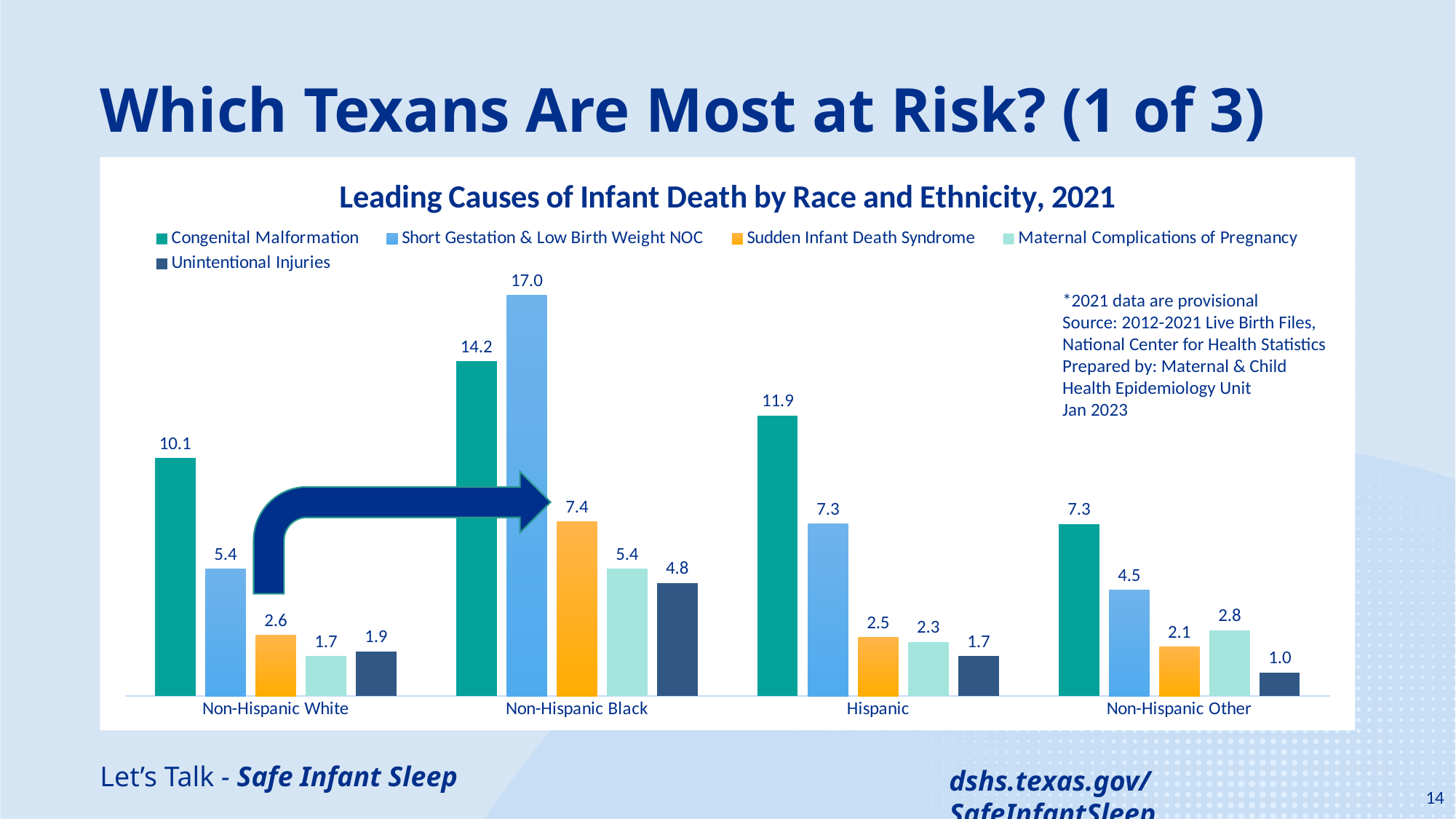
Which race/ethnicity group has the highest value for Short Gestation & Low Birth Weight NOC? Non-Hispanic Black What is the title of the chart? Leading Causes of Infant Death by Race and Ethnicity, 2021 What is the difference between the Congenital Malformation values for Non-Hispanic Black and Non-Hispanic White? 4.1 How many series does the legend list? 5 What is the value for Sudden Infant Death Syndrome in the Non-Hispanic White group? 2.6 Which race/ethnicity group has the lowest value for Congenital Malformation? Non-Hispanic Other What is the value for Short Gestation & Low Birth Weight NOC in the Non-Hispanic Black group? 17.0 Which is larger: Sudden Infant Death Syndrome for Non-Hispanic Black or for Hispanic? Non-Hispanic Black What is the value for Unintentional Injuries in the Non-Hispanic Other group? 1.0 How many race/ethnicity groups are shown on the x axis? 4 What is the value for Congenital Malformation in the Hispanic group? 11.9 What kind of chart is shown on the slide? Bar chart